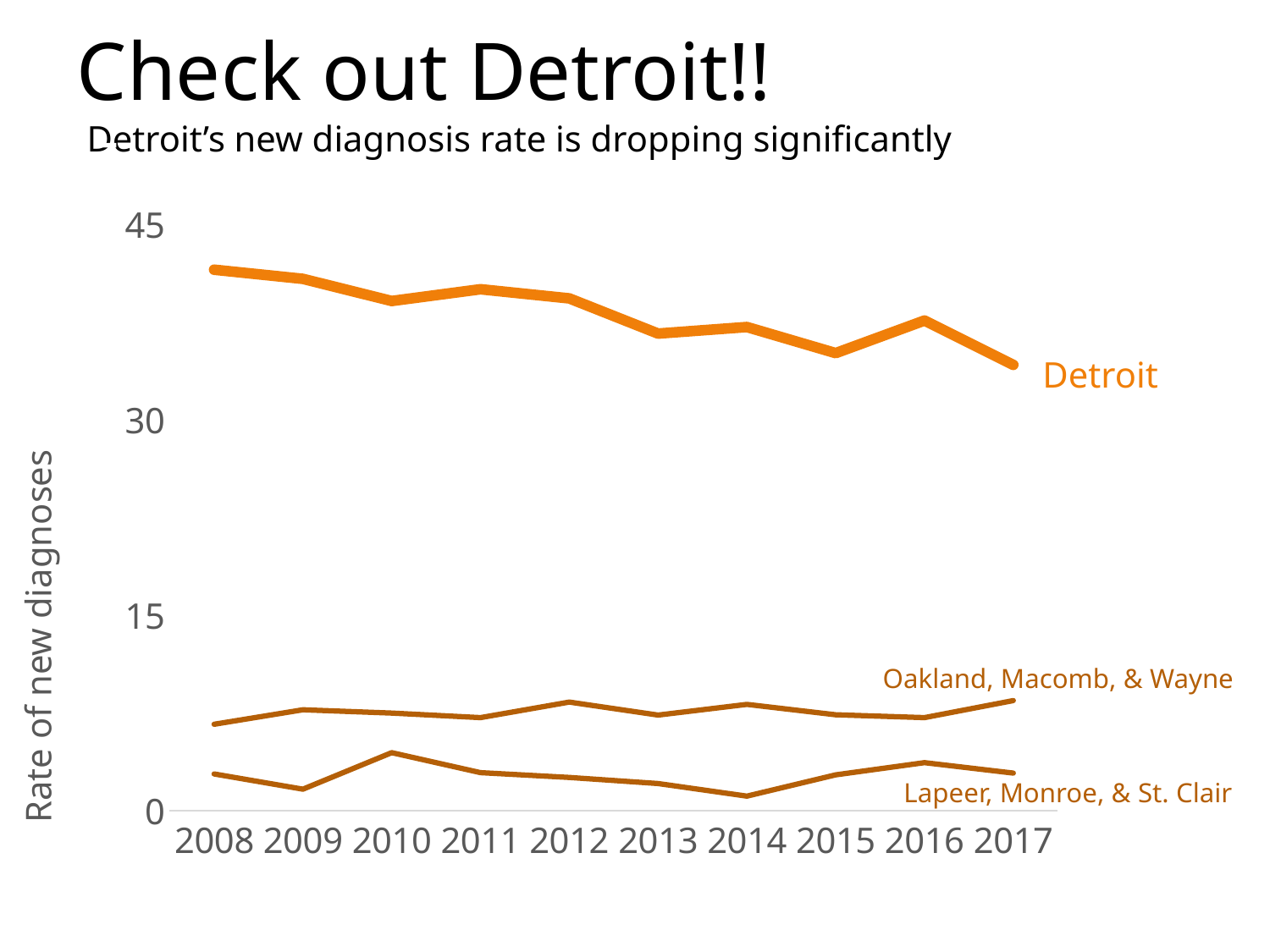
In 2016, which is larger: the value for Oakland, Macomb, & Wayne or the value for Lapeer, Monroe, & St. Clair? Oakland, Macomb, & Wayne How many years are shown along the x axis? 10 Does the Detroit line rise or fall from 2008 to 2017? fall Which series has the lowest values across the chart? Lapeer, Monroe, & St. Clair What kind of chart is shown on the slide? line chart Is the value for Detroit in 2008 greater or less than 30? greater In 2010, which is larger: the value for Detroit or the value for Oakland, Macomb, & Wayne? Detroit What is the label on the y axis of the chart? Rate of new diagnoses Is the value for Oakland, Macomb, & Wayne in 2012 greater or less than 15? less How many series (lines) are plotted on the chart? 3 Is the value for Detroit in 2017 greater or less than 30? greater Which series has the highest values across the chart? Detroit